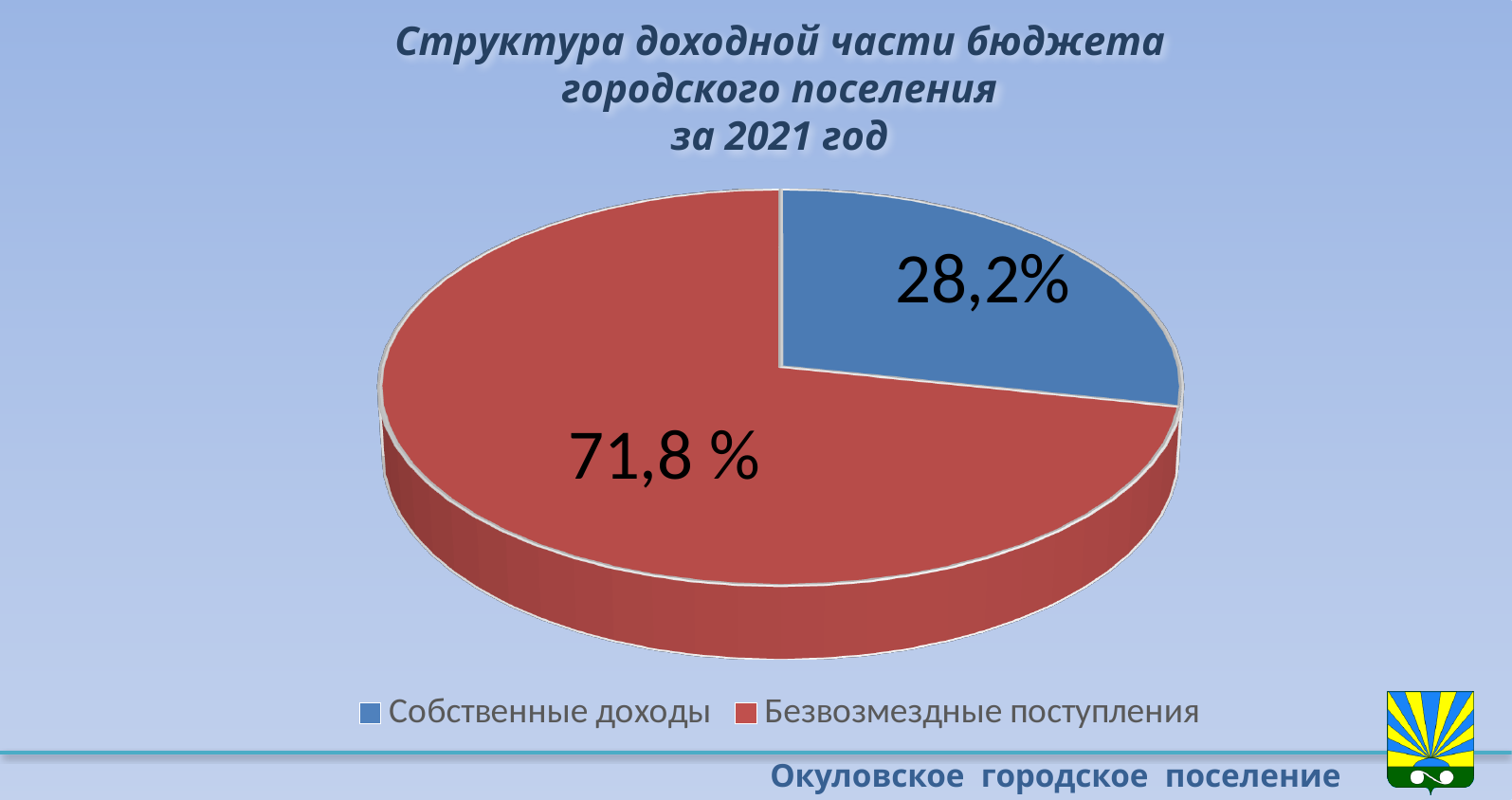
What share of the pie does Собственные доходы have? 28,2% What colour is the slice for Собственные доходы? Blue Which category has the largest slice of the pie? Безвозмездные поступления How many categories does the pie chart show? 2 How many entries does the legend list? 2 What kind of chart is shown on the slide? Pie chart Which is larger, Собственные доходы or Безвозмездные поступления? Безвозмездные поступления Which category has the smallest slice of the pie? Собственные доходы What is the difference in percentage points between Безвозмездные поступления and Собственные доходы? 43,6 What is the title of the chart? Структура доходной части бюджета городского поселения за 2021 год What share of the pie does Безвозмездные поступления have? 71,8 %